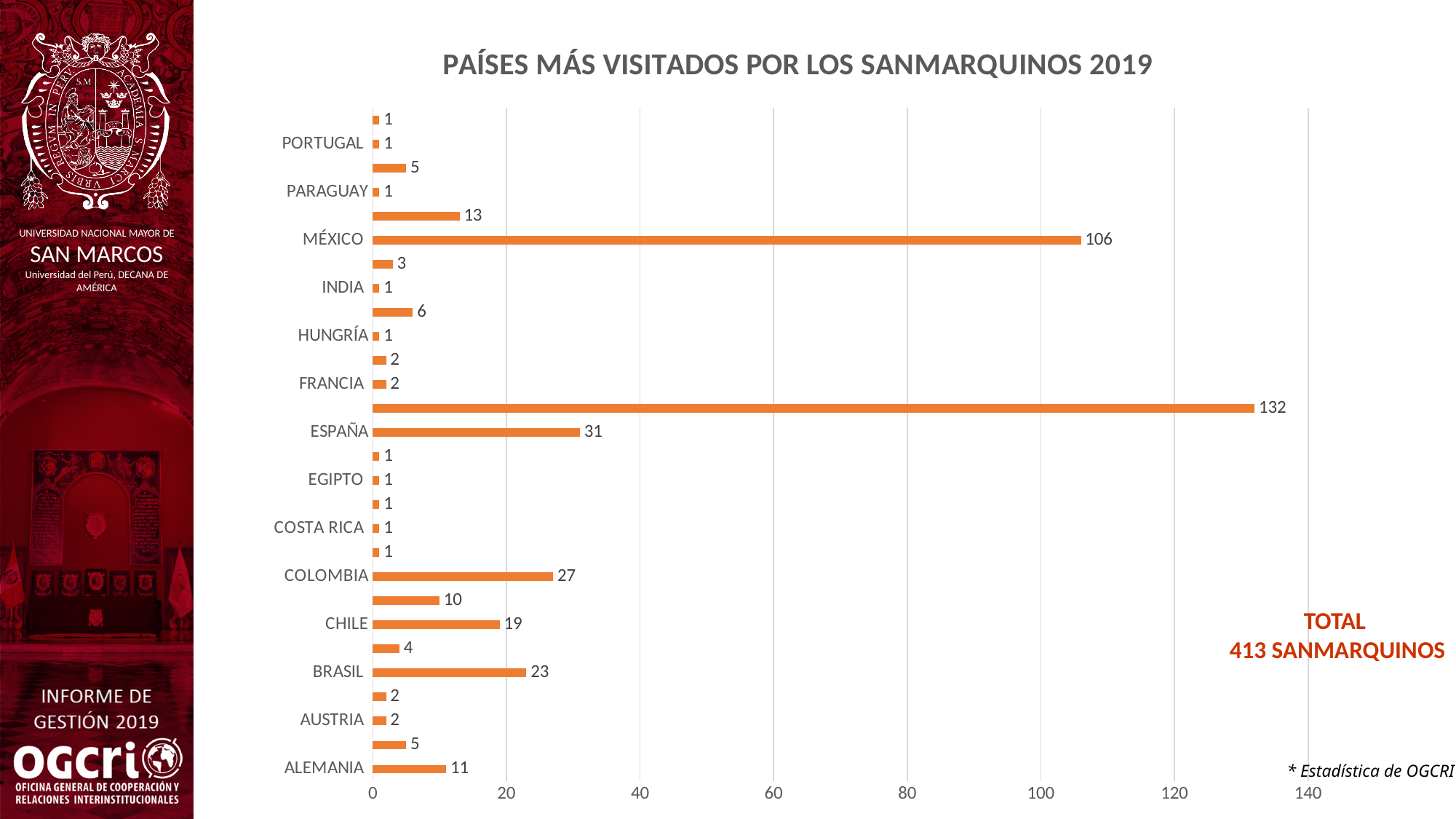
What is the value for BRASIL? 23 What type of chart is shown on the slide? bar chart What is the title of the chart? PAÍSES MÁS VISITADOS POR LOS SANMARQUINOS 2019 What is the difference between the values for MÉXICO and ESPAÑA? 75 What is the value for MÉXICO? 106 Is the value for MÉXICO greater or less than 100? greater What is the value for COLOMBIA? 27 What is the highest value shown on the chart? 132 What is the value for ESPAÑA? 31 How many bars are plotted on the chart? 28 What is the value for ALEMANIA? 11 Which has a larger value, CHILE or BRASIL? BRASIL